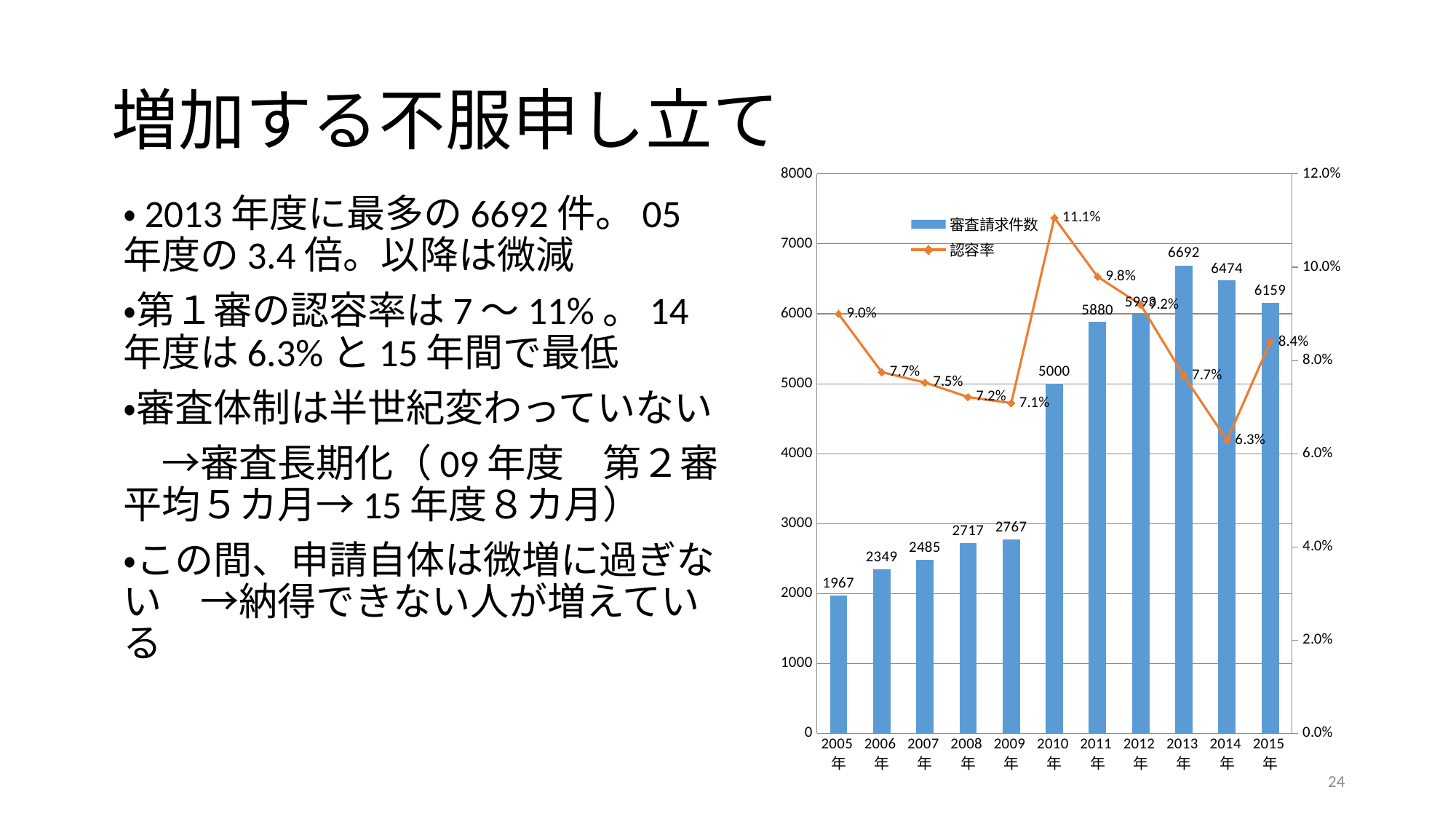
What is the difference in 審査請求件数 between 2013年 and 2014年? 218 What is the 審査請求件数 value for 2013年? 6692 Is the 審査請求件数 for 2009年 greater or less than 3000? less How many years are shown on the x axis of the chart? 11 How many series does the chart legend list? 2 What is the 審査請求件数 value for 2005年? 1967 What is the 認容率 value for 2010年? 11.1% Which is larger, the 審査請求件数 for 2010年 or for 2011年? 2011年 Which year has the highest 審査請求件数? 2013年 Which year has the lowest 認容率? 2014年 What is the 認容率 value for 2014年? 6.3% What kind of chart is used to show 審査請求件数? bar chart